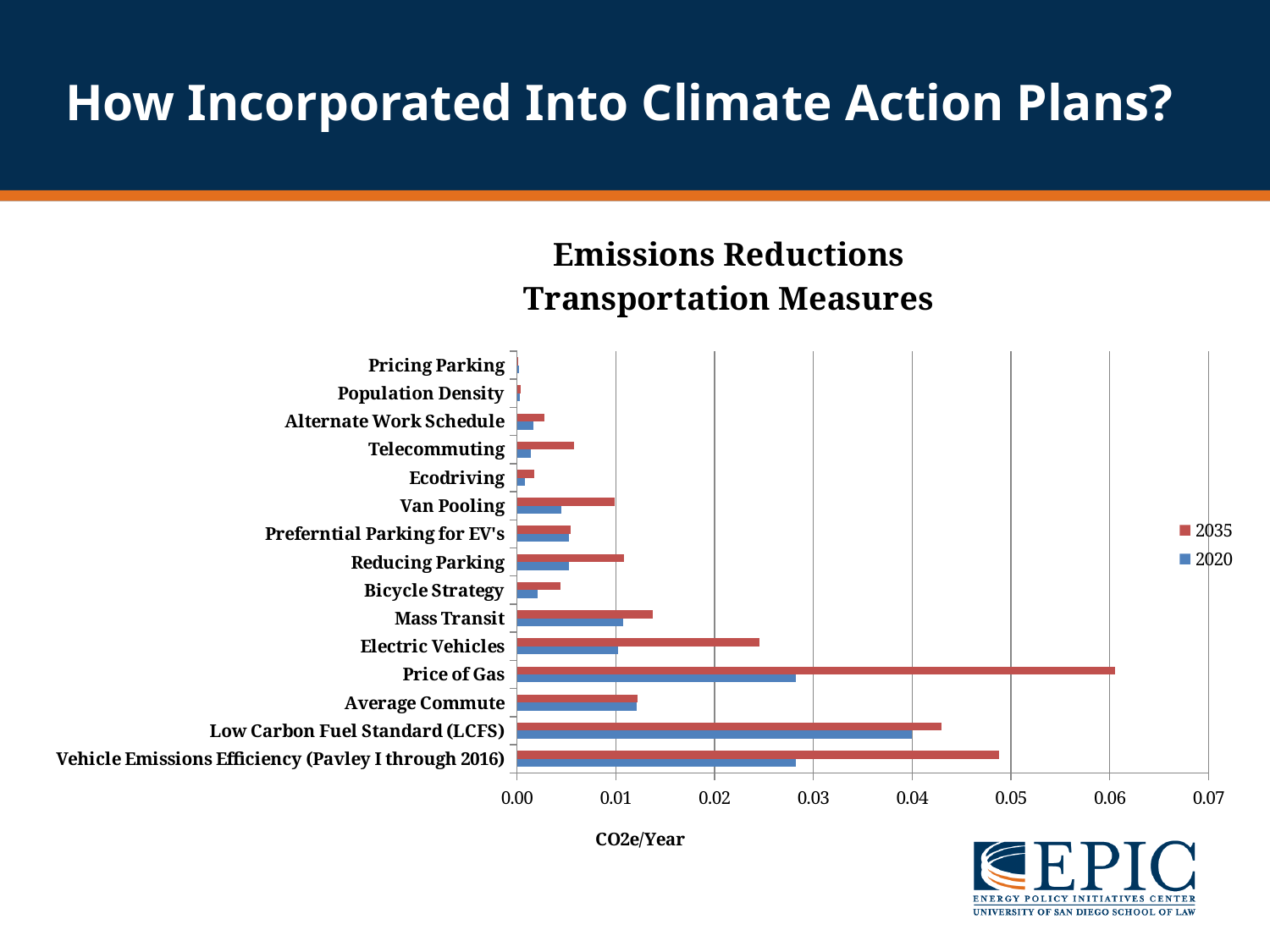
How many series does the legend list? 2 How many transportation measures (categories) are plotted on the chart? 15 Is the 2020 value for Price of Gas greater or less than 0.03? less Which transportation measure has the highest 2020 value? Low Carbon Fuel Standard (LCFS) Which has the larger 2035 value, Telecommuting or Ecodriving? Telecommuting Which transportation measure has the highest 2035 value? Price of Gas Is the 2035 value for Electric Vehicles greater or less than 0.02? greater Is the 2035 value for Low Carbon Fuel Standard (LCFS) greater or less than 0.04? greater What kind of chart is shown on the slide? bar chart For Van Pooling, which series has the larger value, 2035 or 2020? 2035 What is the label on the horizontal axis of the chart? CO2e/Year